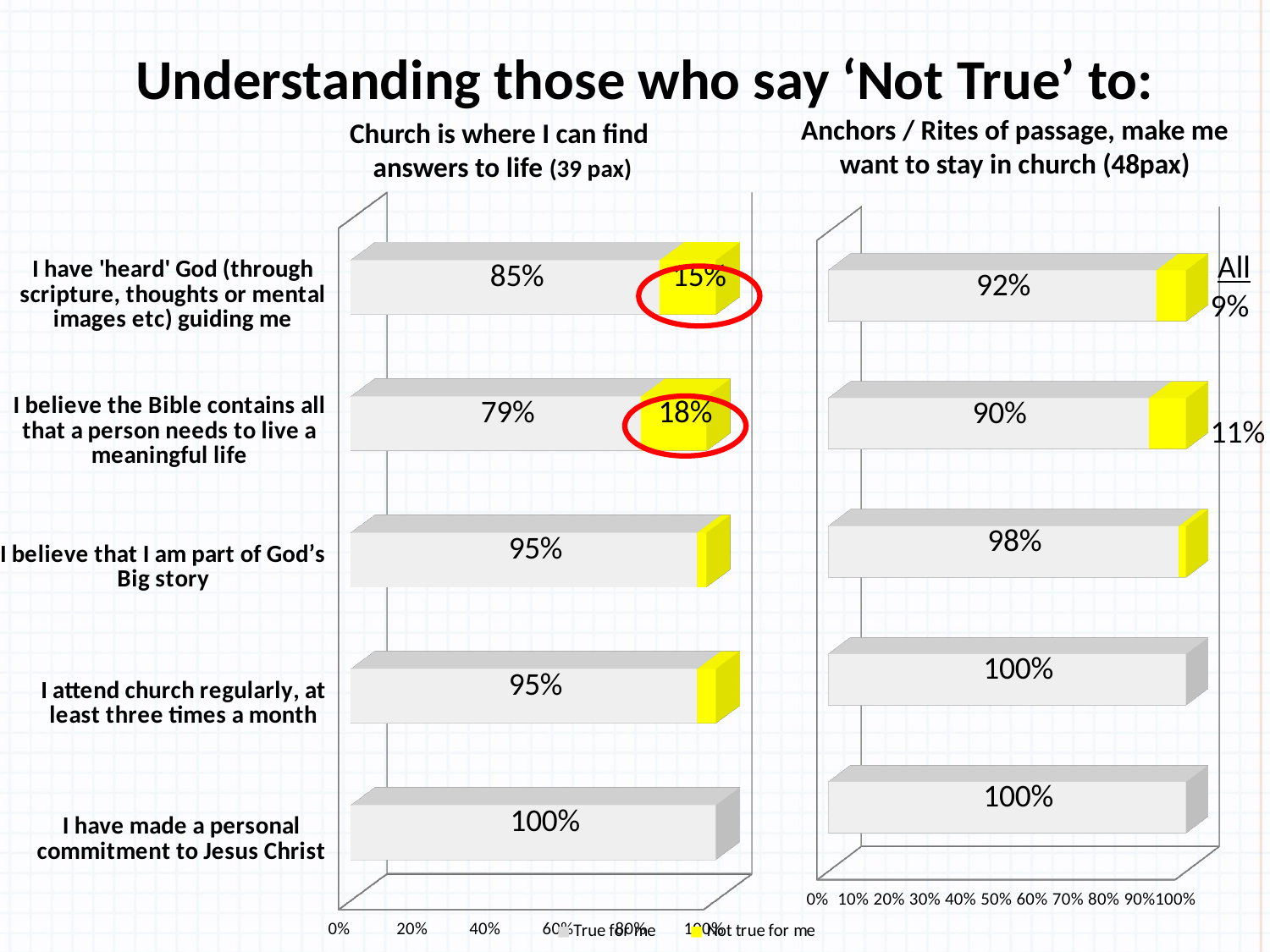
How many statements (categories) are plotted in the 'Church is where I can find answers to life (39 pax)' chart? 5 How many series does the legend list? 2 In the 'Church is where I can find answers to life (39 pax)' chart, what percentage said 'True for me' to 'I have 'heard' God (through scripture, thoughts or mental images etc) guiding me'? 85% In the 'Church is where I can find answers to life (39 pax)' chart, what is the difference between the 'True for me' values for 'I have 'heard' God' and 'I believe the Bible contains all that a person needs'? 6% In the 'Anchors / Rites of passage, make me want to stay in church (48pax)' chart, what is the 'True for me' value for 'I believe that I am part of God's Big story'? 98% What type of chart is used on this slide? Bar chart In the 'Church is where I can find answers to life (39 pax)' chart, which statement has the lowest 'True for me' percentage? I believe the Bible contains all that a person needs to live a meaningful life Which chart shows a higher 'True for me' value for 'I attend church regularly, at least three times a month': the left chart (39 pax) or the right chart (48pax)? The right chart (48pax) In the 'Anchors / Rites of passage, make me want to stay in church (48pax)' chart, what is the 'True for me' value for 'I believe the Bible contains all that a person needs to live a meaningful life'? 90% In the 'Church is where I can find answers to life (39 pax)' chart, what percentage said 'Not true for me' to 'I believe the Bible contains all that a person needs to live a meaningful life'? 18% In the 'Anchors / Rites of passage, make me want to stay in church (48pax)' chart, which statement has the lowest 'True for me' percentage? I believe the Bible contains all that a person needs to live a meaningful life In the 'Church is where I can find answers to life (39 pax)' chart, is the 'True for me' value for 'I have 'heard' God' greater or less than 80%? greater